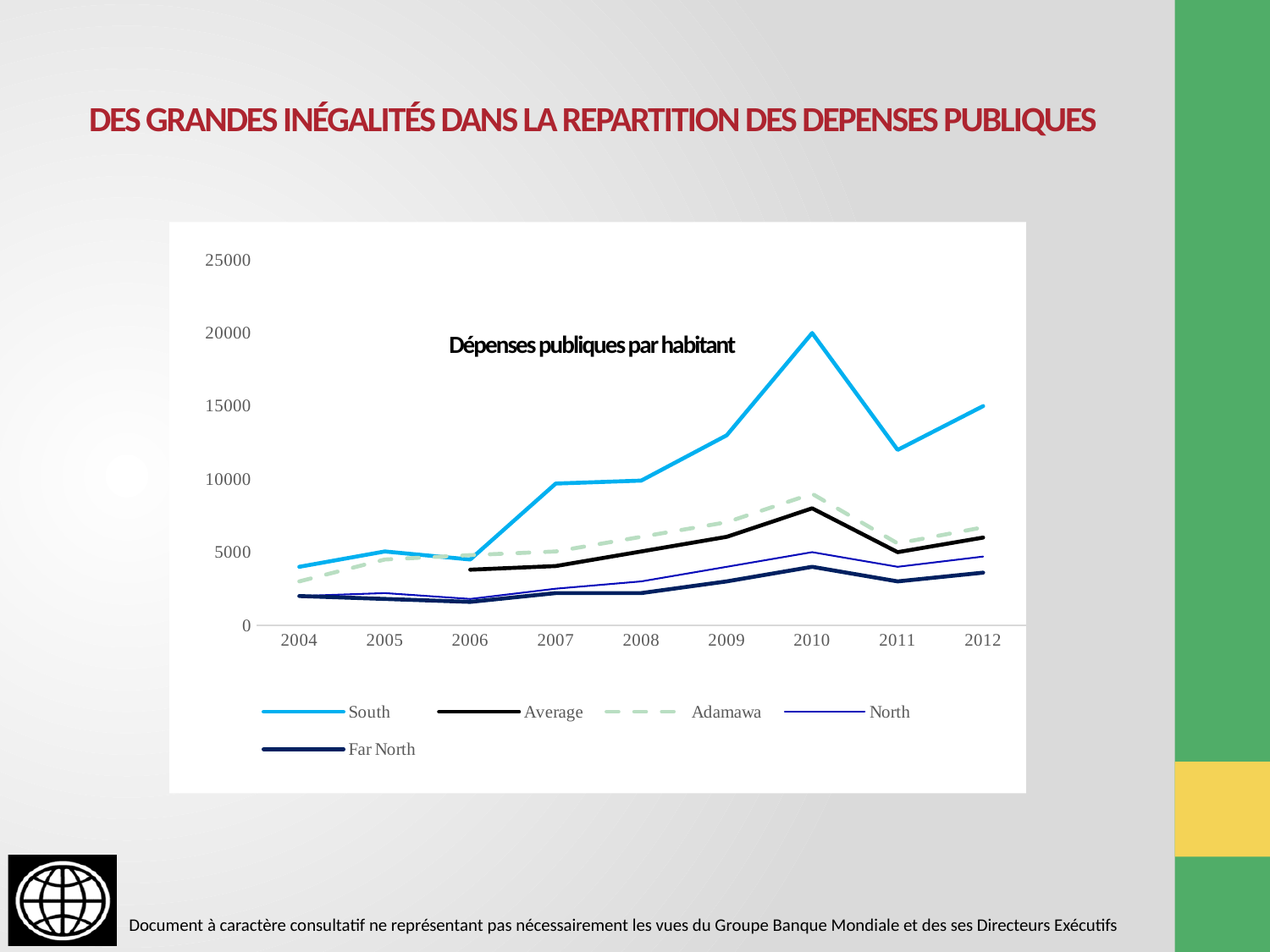
Is the value for South in 2004 greater or less than 5000? less Which series has the highest value in 2010? South How many series does the legend list? 5 What is the title printed inside the chart? Dépenses publiques par habitant What kind of chart is shown on the slide? line chart Which series has the lowest value in 2010? Far North Which is larger in 2010, the value for Adamawa or the value for Average? Adamawa Is the value for South in 2010 greater or less than 15000? greater How many years are shown on the x axis? 9 In which year does the South series reach its peak? 2010 Is the value for Average in 2010 greater or less than 10000? less Does the South series rise or fall between 2006 and 2010? rise